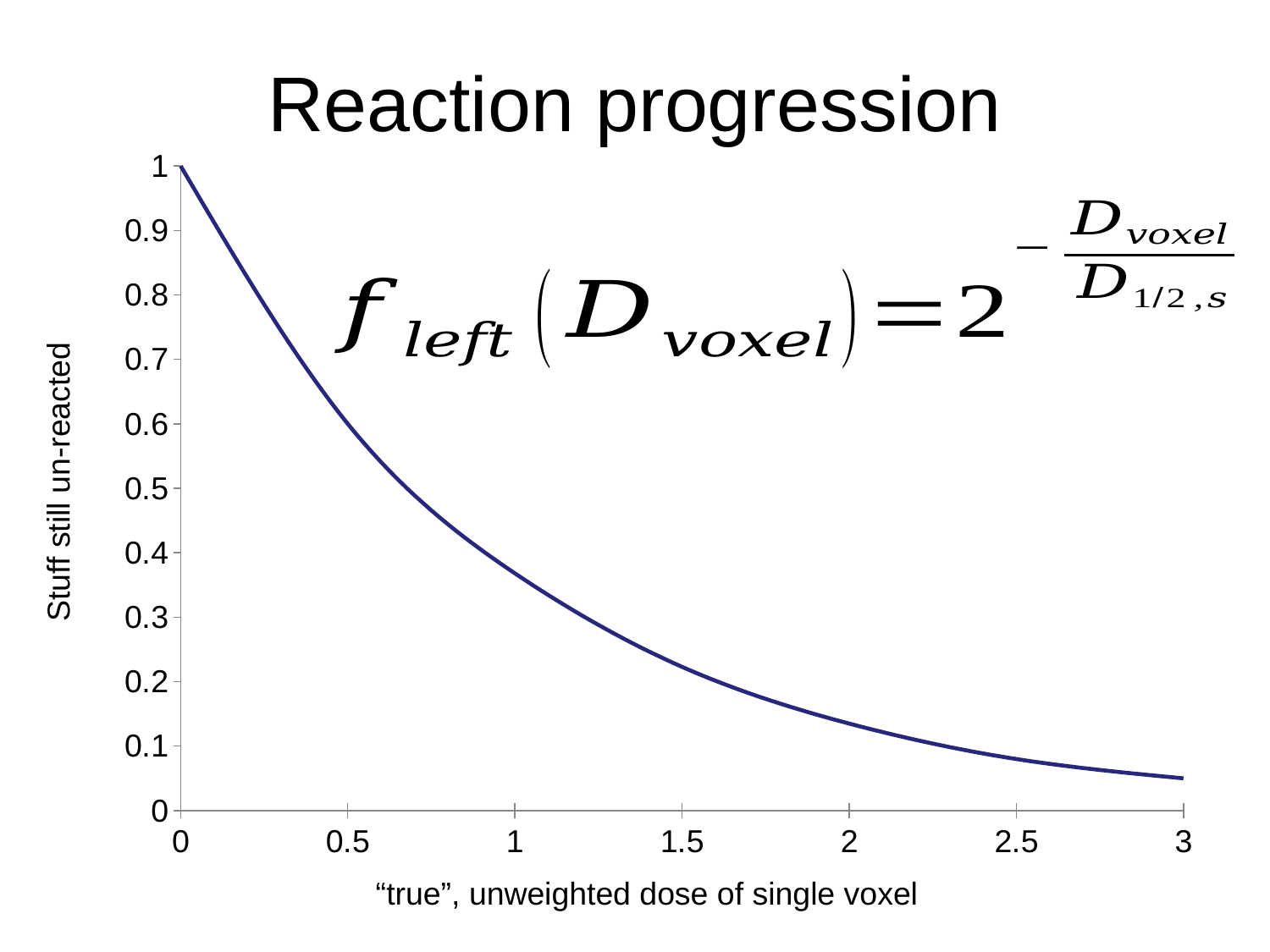
Is the value of the curve at a dose of 1 greater or less than 0.5? less Is the value of the curve at a dose of 3 greater or less than 0.1? less What kind of chart is shown on the slide? line chart Is the value of the curve at a dose of 0.5 greater or less than 0.5? greater Does the curve rise or fall as the dose increases along the x axis? fall At which dose shown on the x axis is the curve at its highest? 0 What is the value of the curve at a dose of 0? 1 What is the title of the chart? Reaction progression At which dose is the curve higher, 0.5 or 2? 0.5 What is the label of the y axis? Stuff still un-reacted